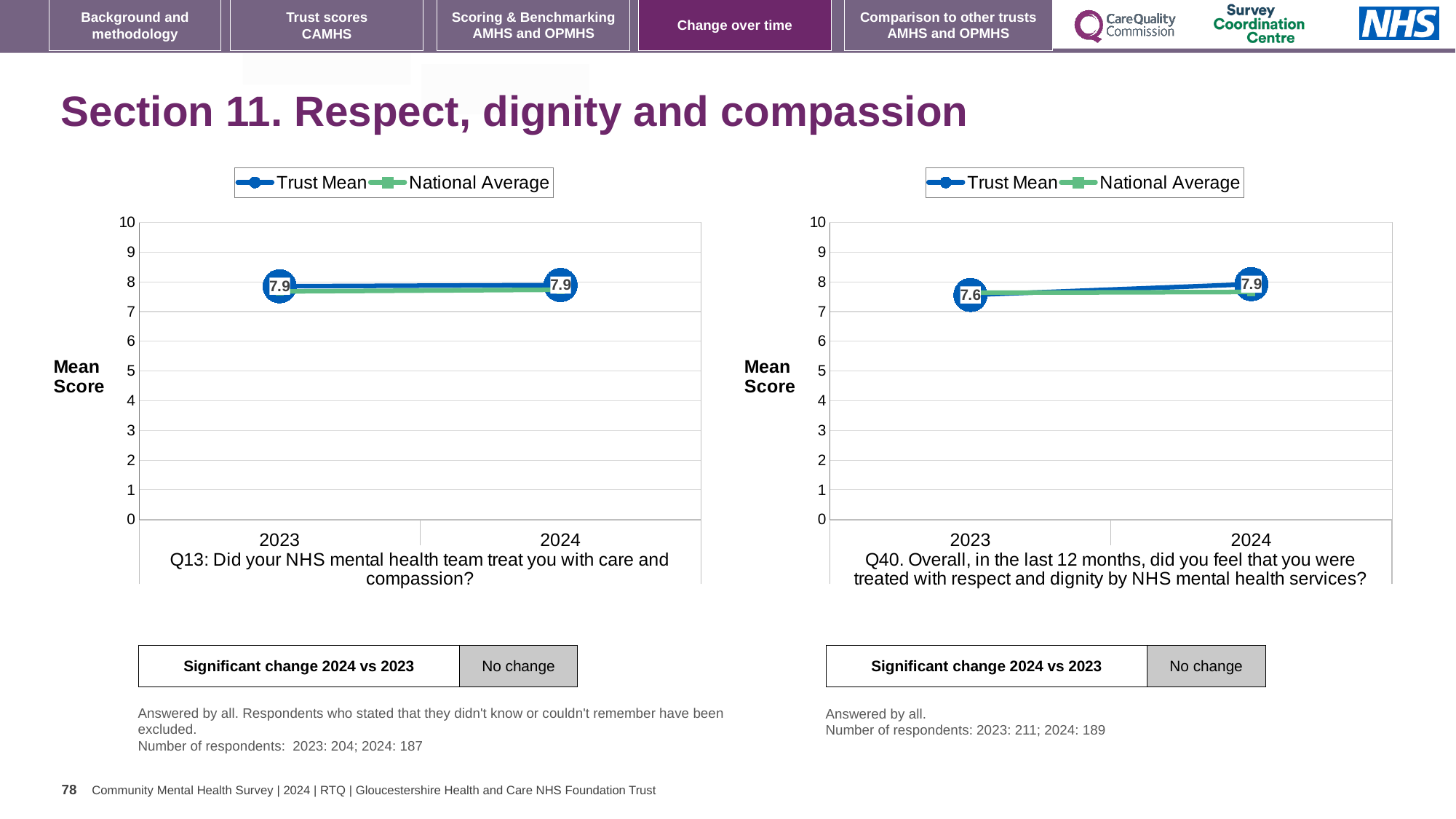
In the Q13 chart on the left, what is the Trust Mean score for 2024? 7.9 How many years are shown on the x axis of the Q13 chart on the left? 2 In the Q40 chart on the right, what is the Trust Mean score for 2023? 7.6 In the Q13 chart on the left, is the National Average value for 2024 greater or less than 5? greater In the Q40 chart on the right, which year has the higher Trust Mean score, 2023 or 2024? 2024 What are the two series named in the legend of the Q13 chart on the left? Trust Mean and National Average In the Q13 chart on the left, what is the Trust Mean score for 2023? 7.9 How many series does the legend of the Q40 chart on the right list? 2 What type of chart is the Q13 chart on the left? line chart In the Q40 chart on the right, by how much did the Trust Mean change from 2023 to 2024? 0.3 In the Q40 chart on the right, does the Trust Mean rise or fall from 2023 to 2024? rise In the Q40 chart on the right, what is the Trust Mean score for 2024? 7.9